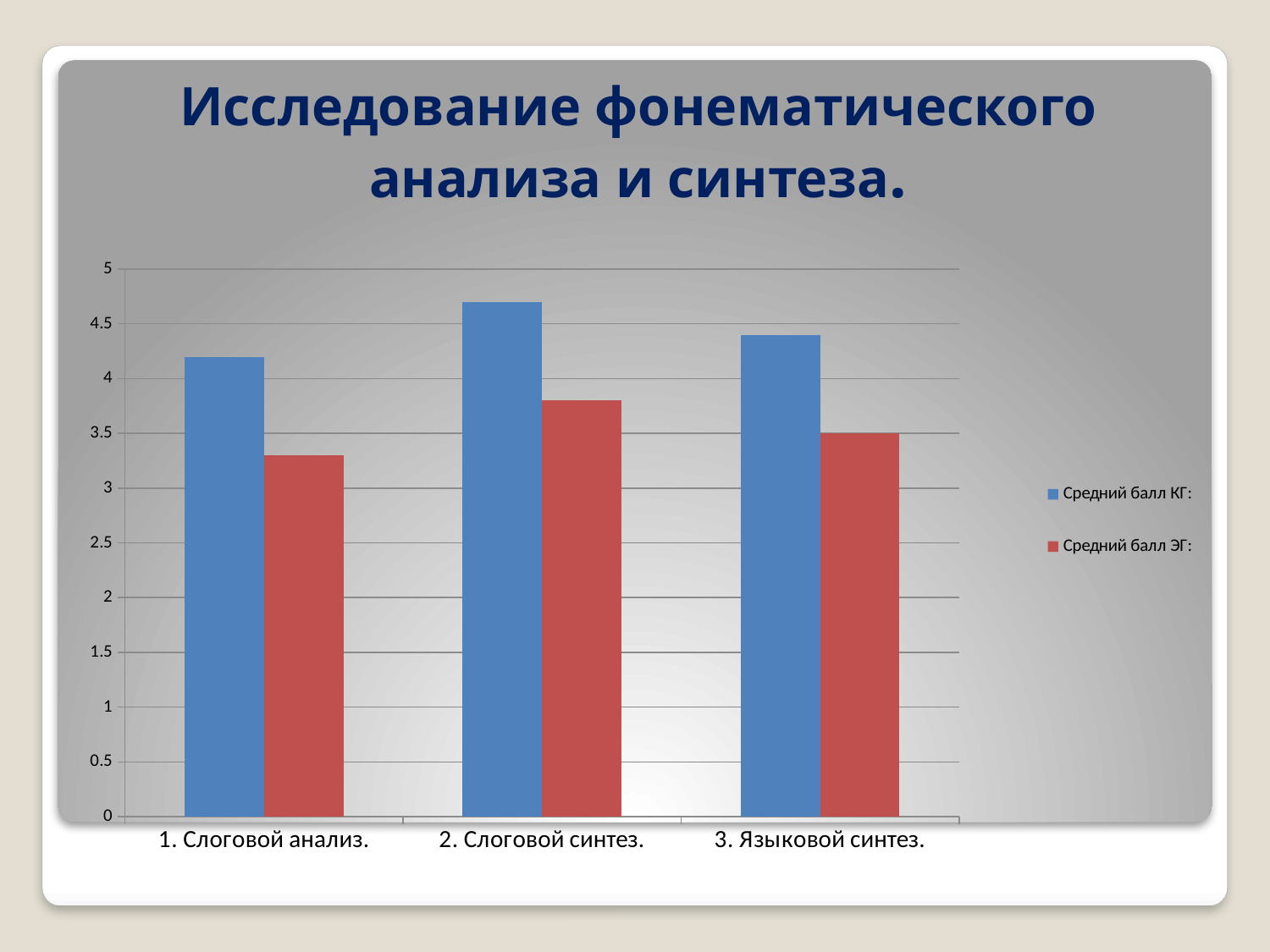
Which category has the highest value for the series "Средний балл КГ:"? 2. Слоговой синтез. Which category has the lowest value for the series "Средний балл КГ:"? 1. Слоговой анализ. Is the value of "Средний балл ЭГ:" for "1. Слоговой анализ." greater or less than 3.5? less Which category has the lowest value for the series "Средний балл ЭГ:"? 1. Слоговой анализ. Is the value of "Средний балл КГ:" for "3. Языковой синтез." greater or less than 4? greater What kind of chart is shown on the slide? Bar chart For the category "1. Слоговой анализ.", which series has the larger value, "Средний балл КГ:" or "Средний балл ЭГ:"? Средний балл КГ: How many series does the legend list? 2 What is the title of the slide containing the chart? Исследование фонематического анализа и синтеза. How many categories are shown on the x axis of the chart? 3 Is the value of "Средний балл КГ:" for "2. Слоговой синтез." greater or less than 4.5? greater Which colour represents the series "Средний балл ЭГ:" in the chart? Red